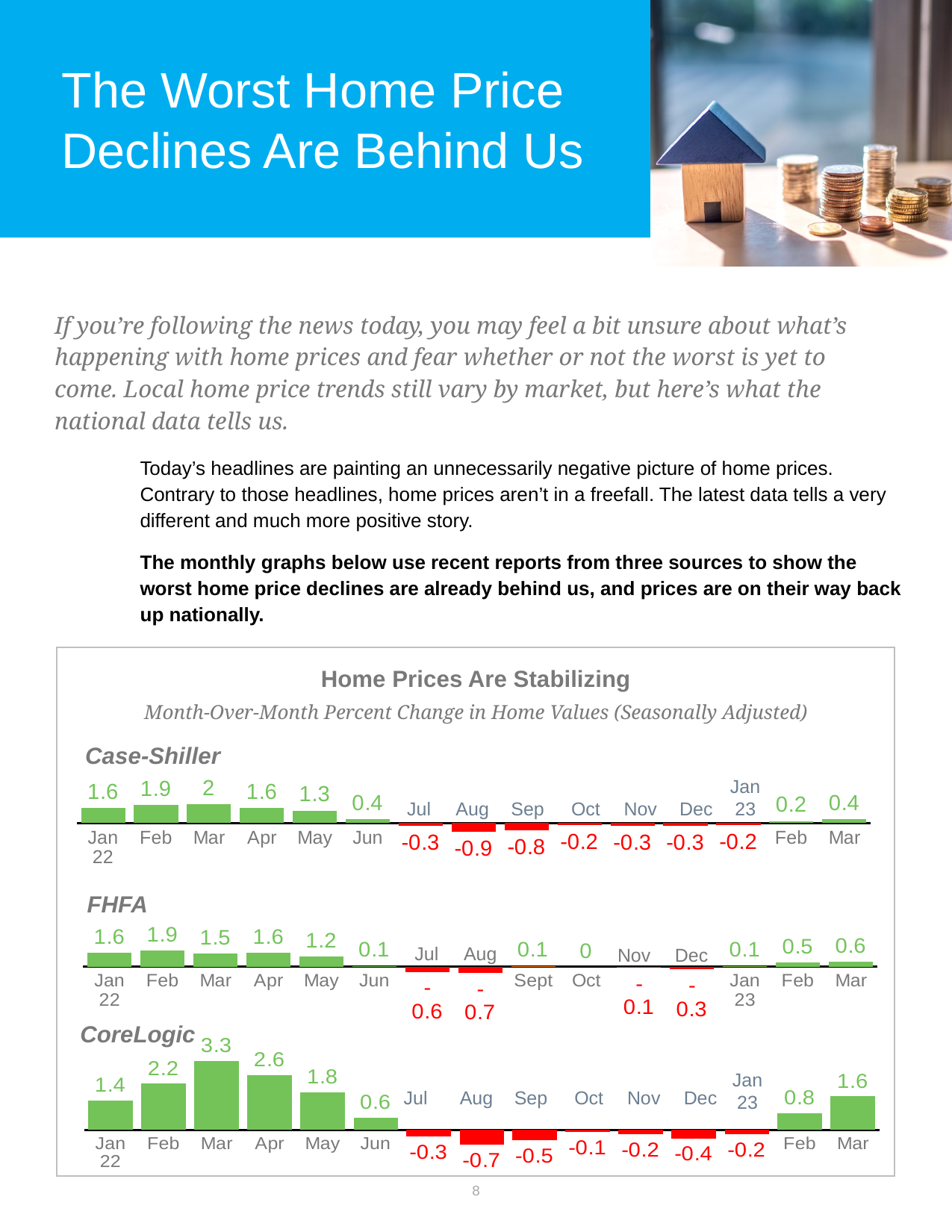
In the FHFA chart, which month has the lowest value? Aug What type of chart is used for the Case-Shiller, FHFA and CoreLogic data? Bar chart In the CoreLogic chart, which is larger, the value for Feb 23 or the value for Mar 23? Mar 23 How many months are plotted in the Case-Shiller chart? 15 In the CoreLogic chart, what is the difference between the Mar 2022 value and the Feb 2022 value? 1.1 What is the subtitle shown under the title 'Home Prices Are Stabilizing'? Month-Over-Month Percent Change in Home Values (Seasonally Adjusted) In the Case-Shiller chart, which month has the highest value? Mar (2022) In the FHFA chart, what is the value for Oct? 0 In the Case-Shiller chart, which month has the lowest value? Aug In the Case-Shiller chart, what is the value for Aug? -0.9 In the FHFA chart, what is the value for Mar 23? 0.6 In the CoreLogic chart, which month has the highest value? Mar (2022)